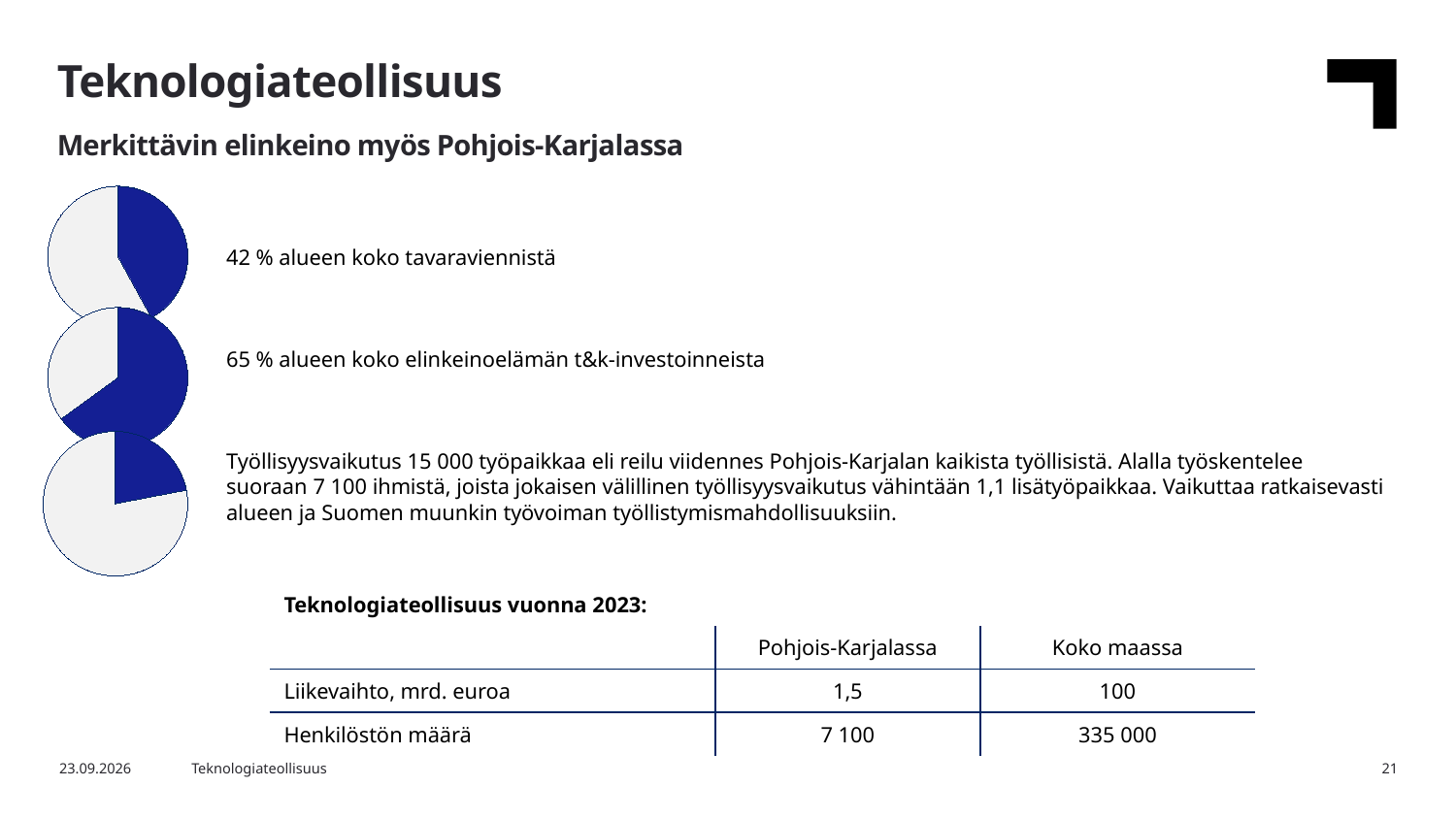
How many pie charts are on the slide? 3 Is the blue slice in the middle pie chart greater or less than 50% of the pie? greater Is the blue slice in the top pie chart greater or less than 50% of the pie? less What kind of charts are shown on the left side of the slide? Pie charts Which of the three pie charts has the smallest blue slice? The bottom one What does the top pie chart's blue slice represent, according to the text next to it? Alueen koko tavaraviennistä Is the blue slice in the bottom pie chart greater or less than 50% of the pie? less Which pie chart has the larger blue slice, the top one or the middle one? The middle one What colour is the highlighted slice in each pie chart? Blue Which of the three pie charts has the largest blue slice? The middle one In the top pie chart, what share does the blue slice represent, according to the text beside it? 42 % In the middle pie chart, what share does the blue slice represent, according to the text beside it? 65 %